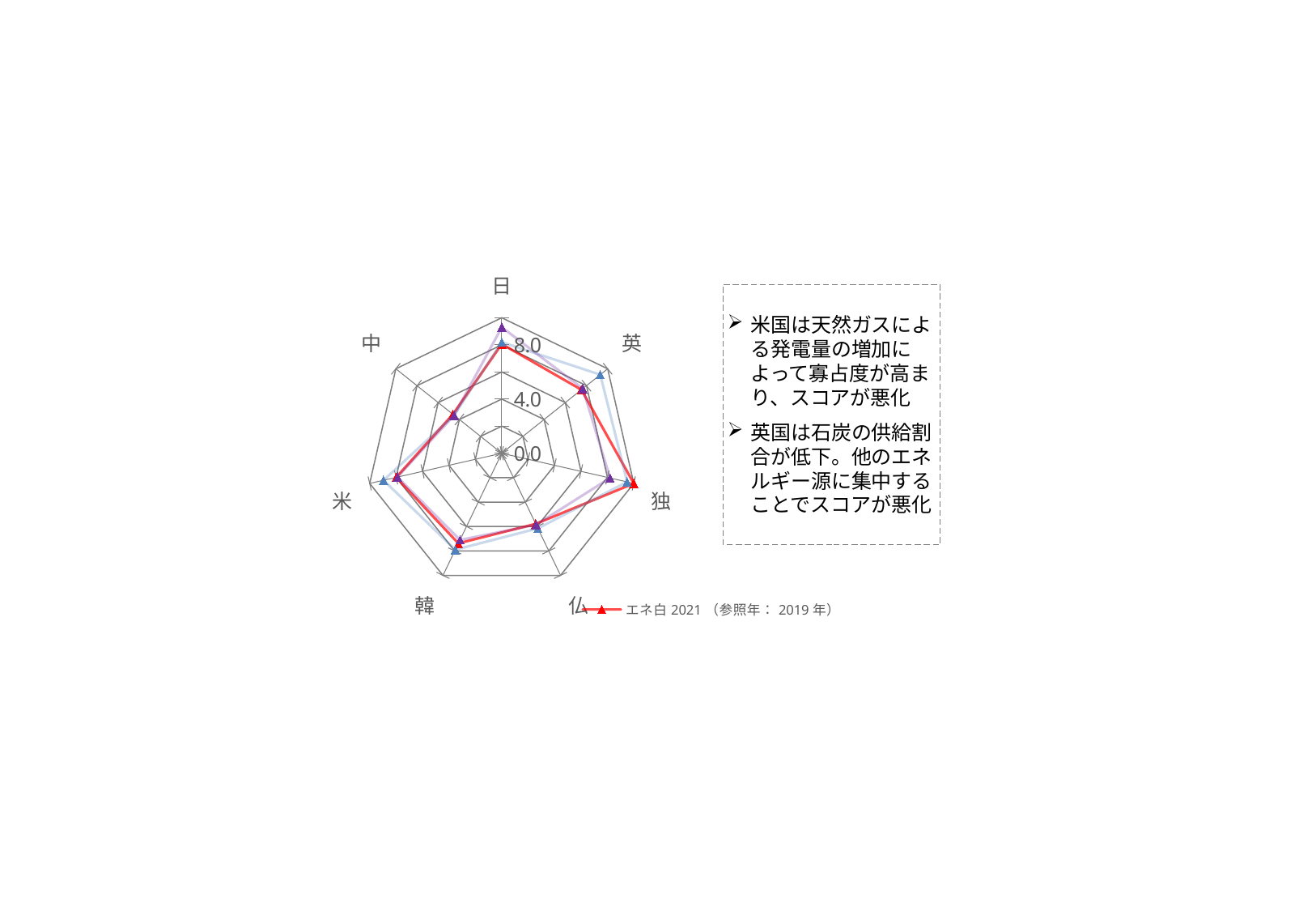
For the red エネ白 2021 series, is the value for 韓 greater or less than 8.0? less How many categories (countries) are plotted around the radar chart? 7 What is the legend entry shown for the red series? エネ白 2021 （参照年： 2019 年） What kind of chart is shown on the slide? radar chart For the red エネ白 2021 series, is the value for 独 greater or less than 8.0? greater For the red エネ白 2021 series, which is larger, the value for 日 or the value for 中? 日 Which category has the highest value for the red エネ白 2021 series? 独 For the red エネ白 2021 series, is the value for 仏 greater or less than 8.0? less Which category has the lowest value for the red エネ白 2021 series? 中 For the red エネ白 2021 series, which is larger, the value for 独 or the value for 仏? 独